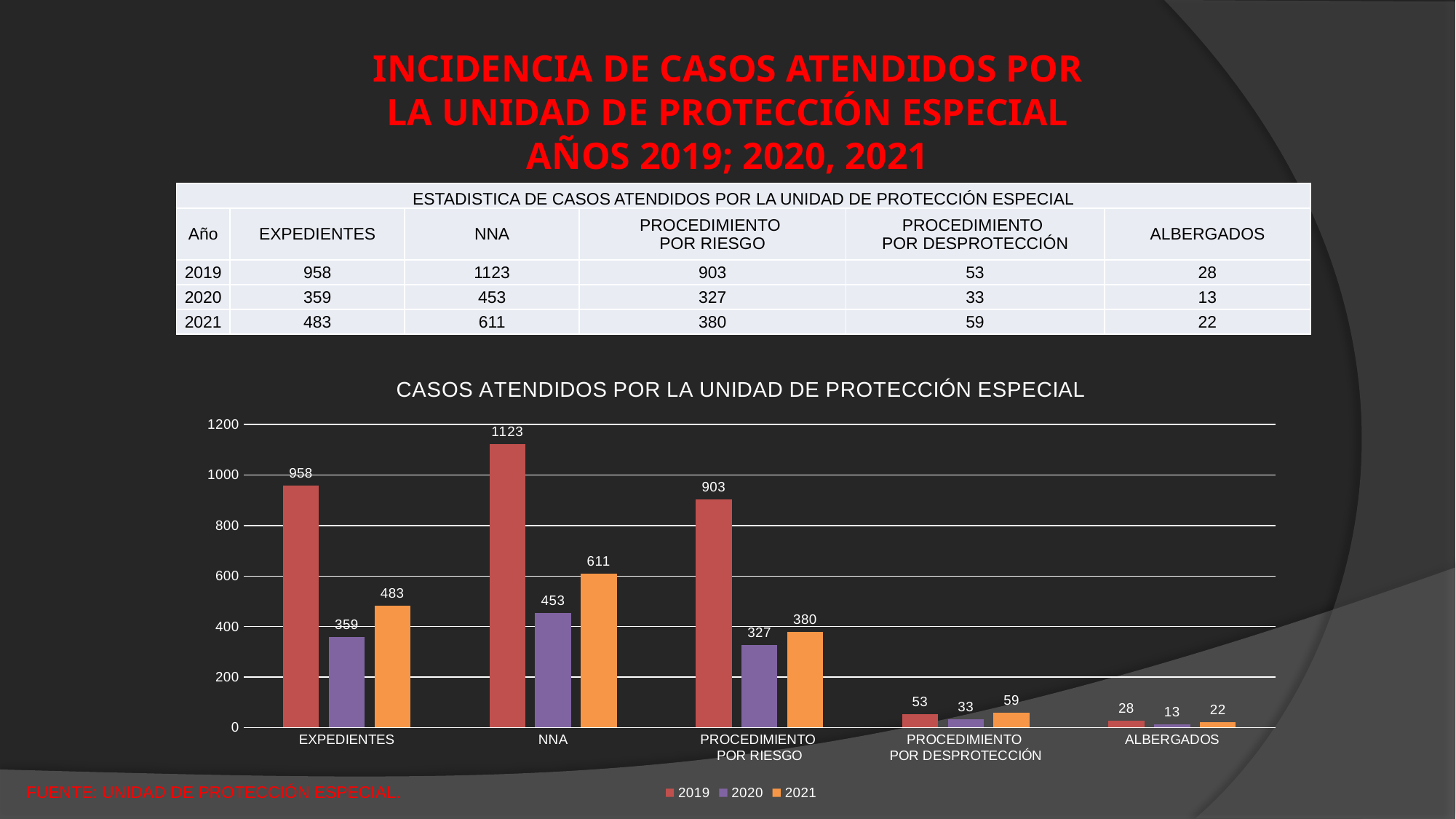
Which category has the lowest value in the 2021 series? ALBERGADOS What kind of chart is shown on the slide? bar chart How many categories are shown on the x axis of the chart? 5 What is the difference between the 2019 and 2020 values for EXPEDIENTES? 599 What is the value for PROCEDIMIENTO POR RIESGO in the 2021 series? 380 What is the value for NNA in the 2019 series? 1123 What is the value for ALBERGADOS in the 2020 series? 13 Which series is shown in orange in the chart? 2021 Which is larger for PROCEDIMIENTO POR DESPROTECCIÓN: the 2019 value or the 2021 value? 2021 Which category has the highest value in the 2019 series? NNA What is the title of the chart? CASOS ATENDIDOS POR LA UNIDAD DE PROTECCIÓN ESPECIAL How many series does the legend list? 3